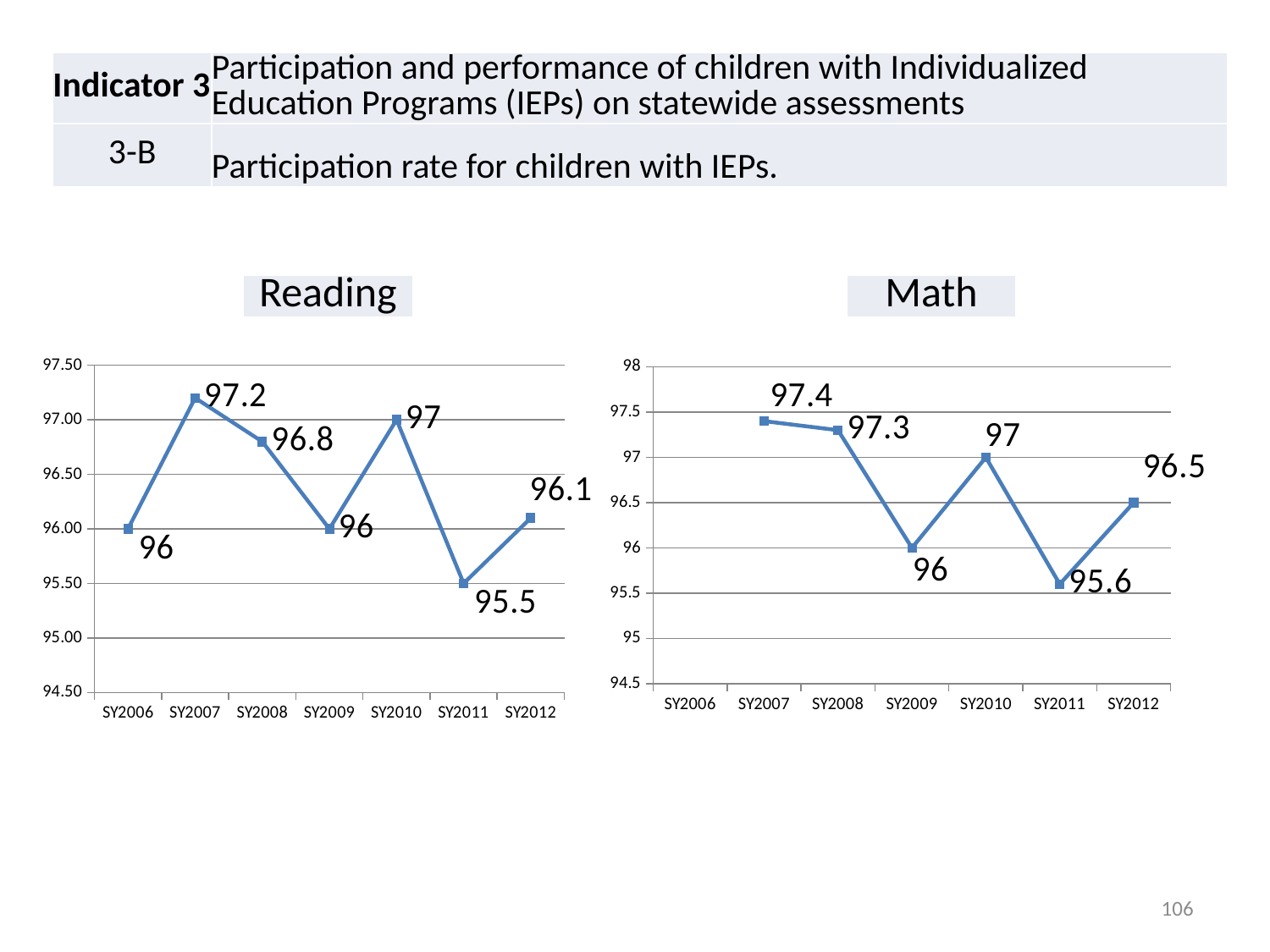
In the Math chart, which school year has the lowest value? SY2011 In the Reading chart, what is the value for SY2011? 95.5 In the Reading chart, what is the value for SY2007? 97.2 What kind of chart is the Math chart? Line chart In the Reading chart, which school year has the highest value? SY2007 In the Math chart, what is the difference between the SY2007 value and the SY2008 value? 0.1 In the Math chart, what is the value for SY2012? 96.5 In the Reading chart, does the value rise or fall from SY2010 to SY2011? Fall In the Math chart, what is the value for SY2009? 96 How many school years are labelled on the x axis of the Reading chart? 7 In the Math chart, which is larger, the value for SY2010 or the value for SY2012? SY2010 In the Reading chart, what is the difference between the SY2007 value and the SY2011 value? 1.7